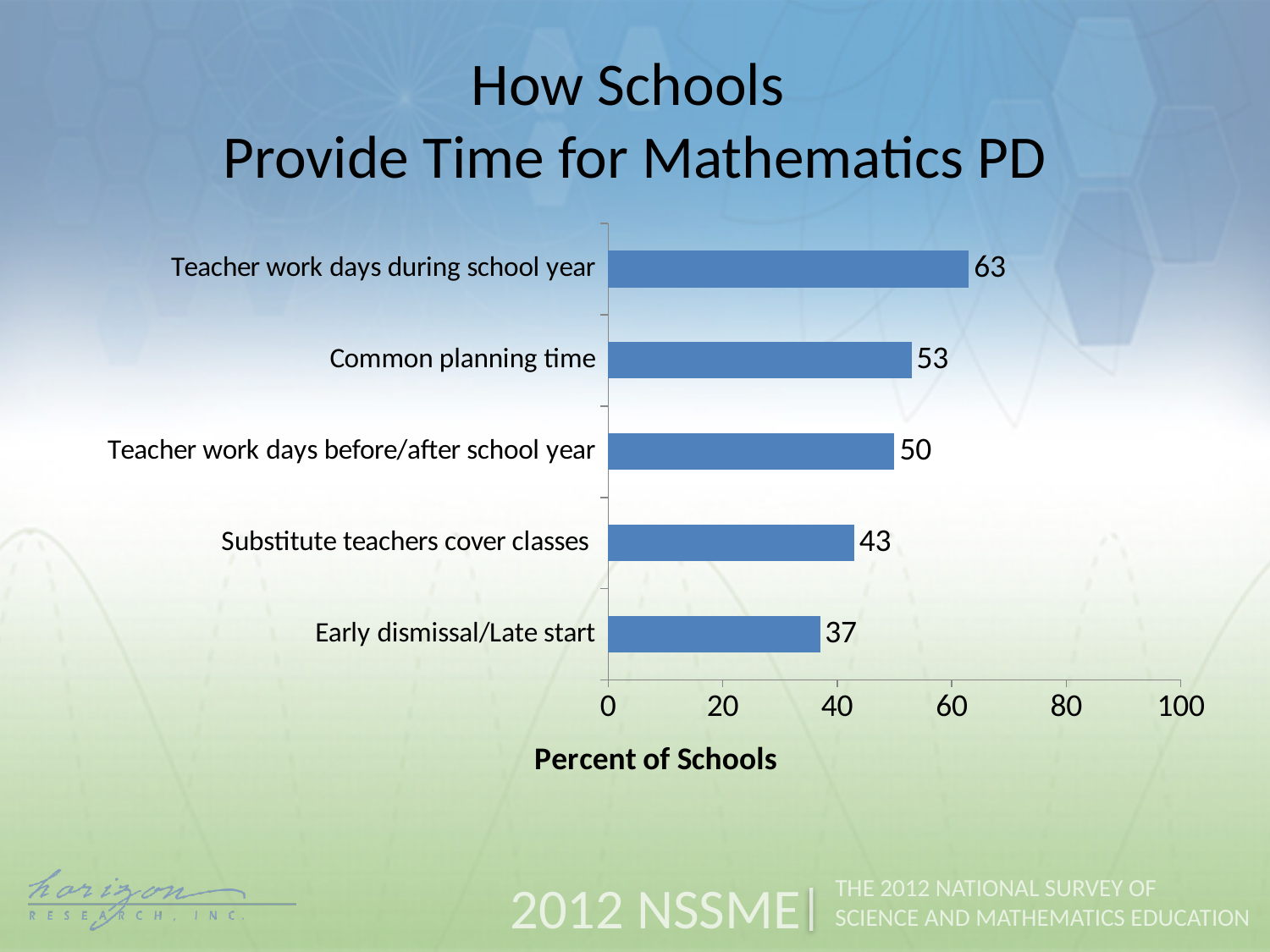
What is the value for Substitute teachers cover classes? 43 What is the value for Early dismissal/Late start? 37 Is the value for Substitute teachers cover classes greater or less than 40? greater What is the label of the horizontal axis? Percent of Schools How many categories are shown in the chart? 5 What is the difference between the values for Teacher work days during school year and Teacher work days before/after school year? 13 Which category has the highest percent of schools? Teacher work days during school year What kind of chart is shown on the slide? Bar chart What percent of schools provide time for mathematics PD through teacher work days during the school year? 63 Which is larger: the value for Common planning time or the value for Substitute teachers cover classes? Common planning time What is the value for Common planning time? 53 Which category has the lowest percent of schools? Early dismissal/Late start